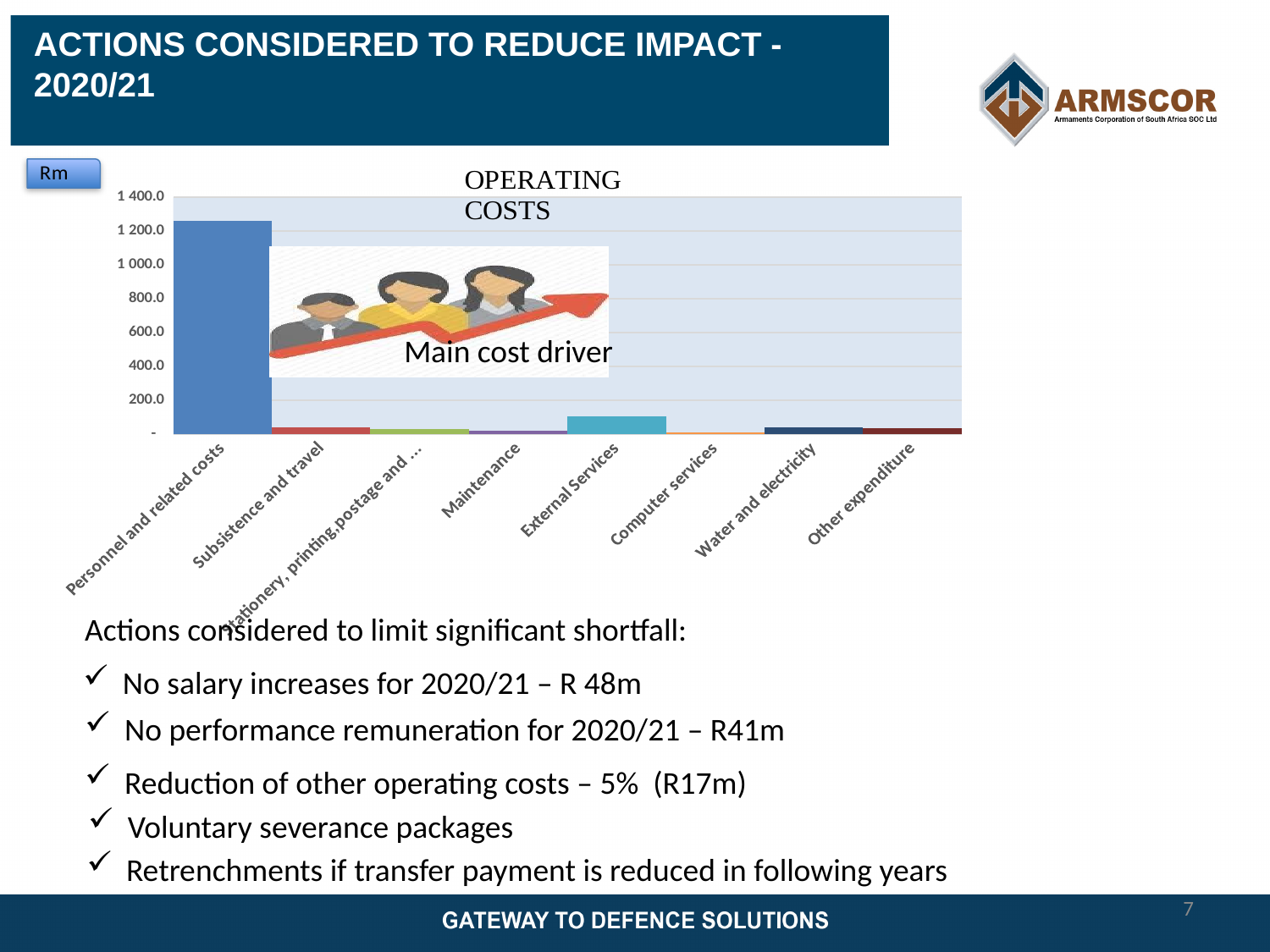
Which is larger, the value for Personnel and related costs or the value for External Services? Personnel and related costs What is the highest value shown on the y axis of the chart? 1 400.0 How many categories are shown on the x axis of the chart? 8 Which is larger, the value for External Services or the value for Maintenance? External Services Is the value for External Services greater or less than 200.0? less Is the value for Subsistence and travel greater or less than 200.0? less What kind of chart is shown on the slide? Bar chart What is the title of the chart? OPERATING COSTS Is the value for Personnel and related costs greater or less than 1 000.0? greater Which category has the highest value in the chart? Personnel and related costs What unit label is shown at the top left of the chart? Rm